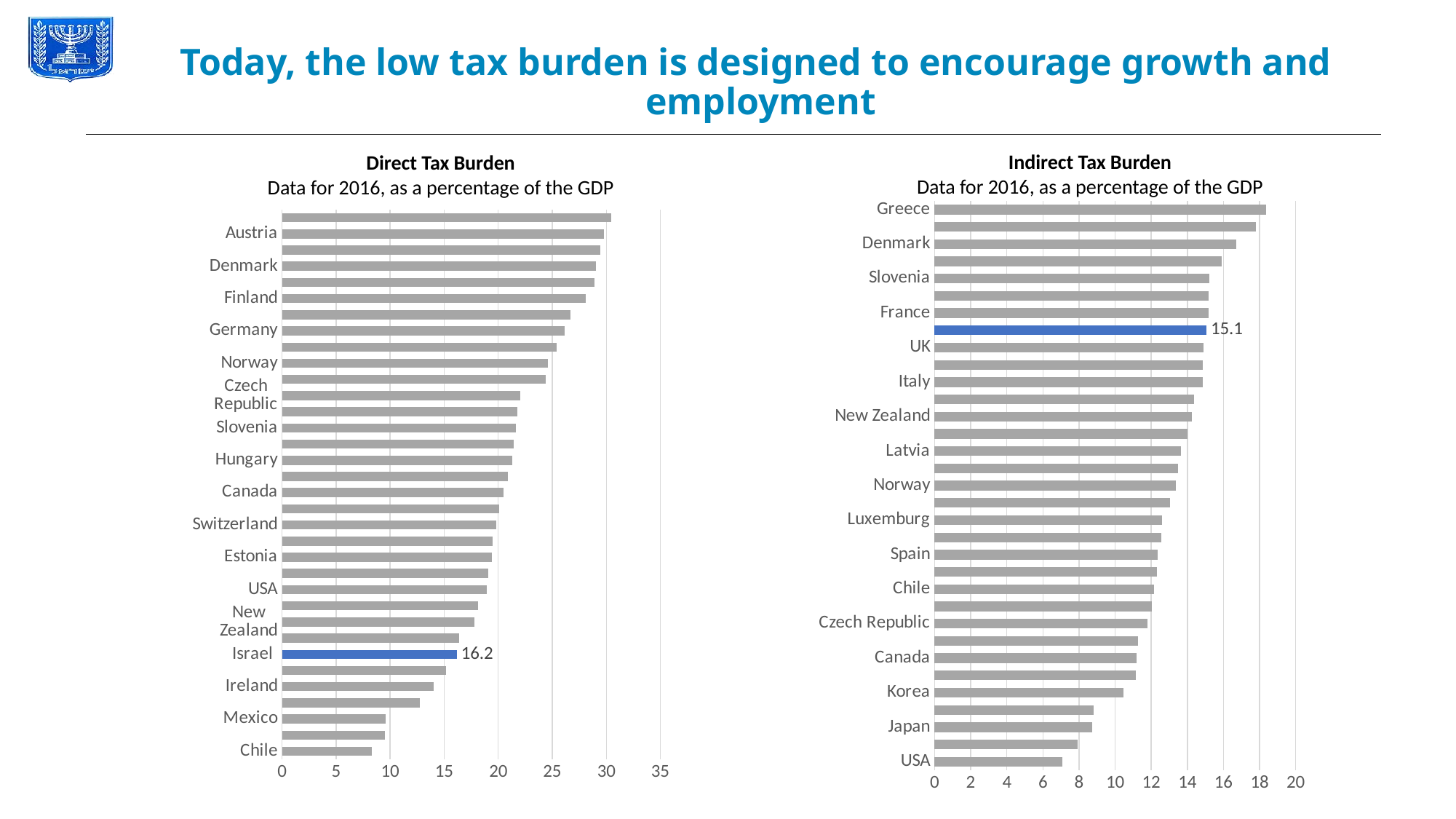
In the Direct Tax Burden chart, is the value for Chile greater or less than 10? less In the Indirect Tax Burden chart, which country has the lowest value? USA In the Direct Tax Burden chart, which country's bar is highlighted in blue? Israel In the Direct Tax Burden chart, what is the value for Israel? 16.2 What kind of chart is the Indirect Tax Burden chart? Bar chart In the Indirect Tax Burden chart, is the value for Greece greater or less than 16? greater In the Direct Tax Burden chart, which has the larger value, Denmark or Mexico? Denmark In the Indirect Tax Burden chart, is the value for Japan greater or less than 10? less In the Indirect Tax Burden chart, which country has the highest value? Greece In the Direct Tax Burden chart, which labelled country has the lowest value? Chile In the Indirect Tax Burden chart, what value is printed on the highlighted blue bar? 15.1